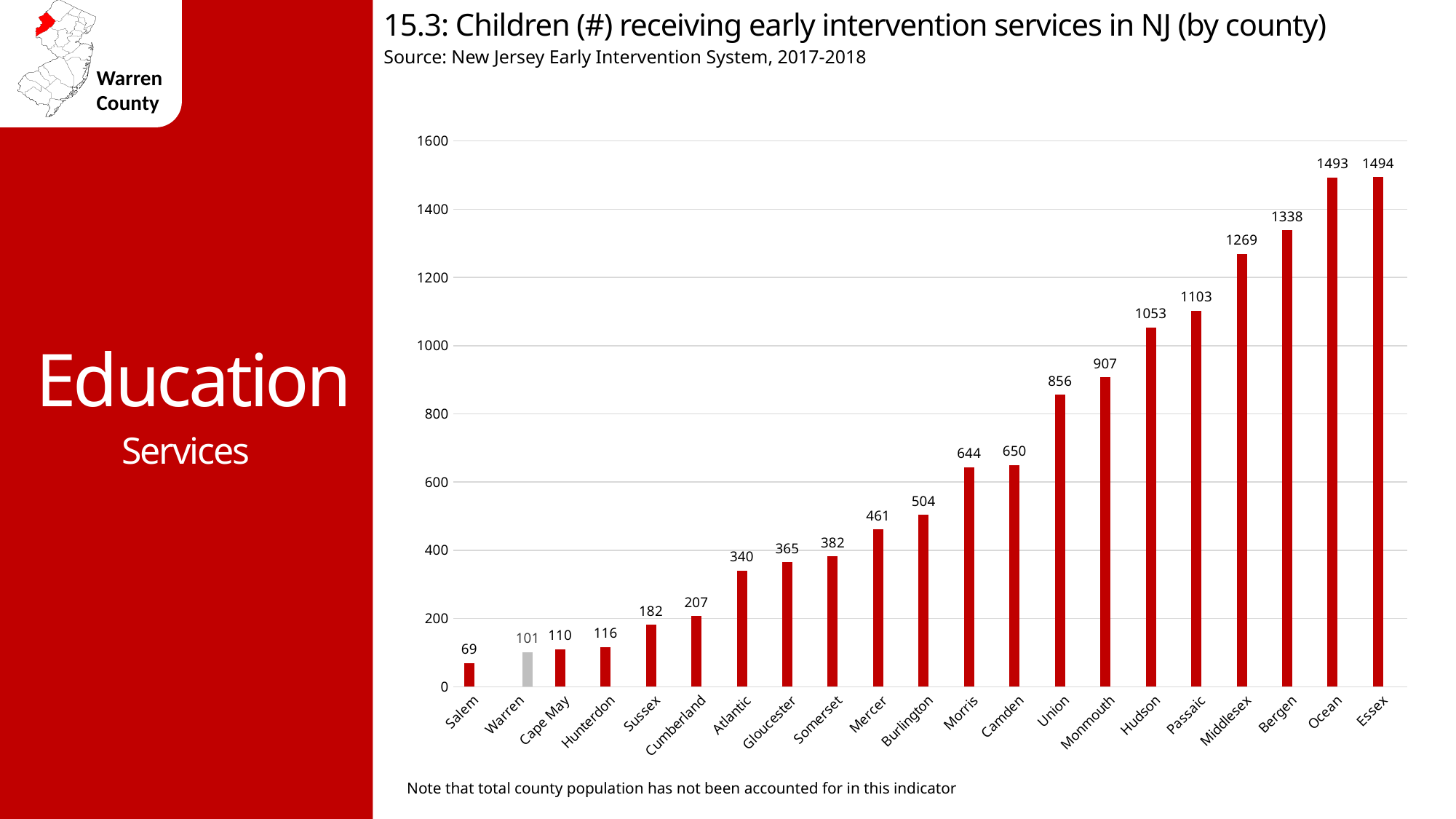
Which has a higher value, Union or Monmouth? Monmouth Which has a higher value, Sussex or Cumberland? Cumberland Which county has the lowest number of children receiving early intervention services? Salem How many children received early intervention services in Warren County? 101 Is the value for Passaic greater or less than 1000? greater What kind of chart is shown on the slide? Bar chart What is the difference between the values for Bergen and Middlesex? 69 What is the value shown for Atlantic? 340 How many counties are shown on the chart? 21 What is the difference between the values for Camden and Morris? 6 Which bar is coloured grey instead of red? Warren What is the value shown for Hudson? 1053